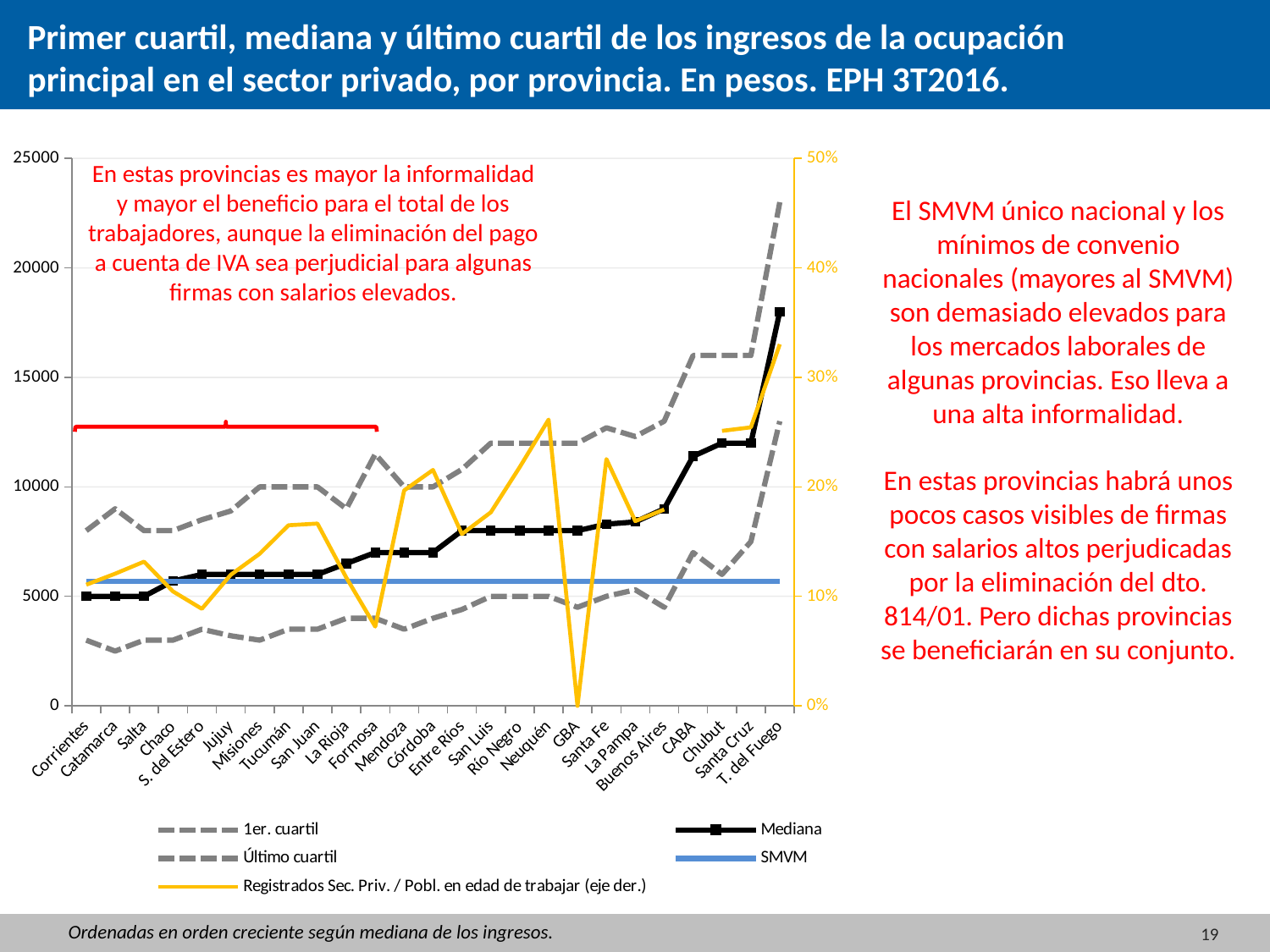
What kind of chart is shown on the slide? line chart Is the Mediana value for Corrientes greater or less than 10000? less Which series in the legend is plotted on the right-hand axis? Registrados Sec. Priv. / Pobl. en edad de trabajar (eje der.) Is the Mediana value for T. del Fuego greater or less than 15000? greater Which province has the highest Mediana value? T. del Fuego How many provinces are shown along the x axis of the chart? 25 How many series does the chart legend list? 5 Is the 1er. cuartil value for Catamarca greater or less than 5000? less Does the Mediana series generally rise or fall from left to right along the x axis? rise Which has the larger Mediana value, CABA or Mendoza? CABA